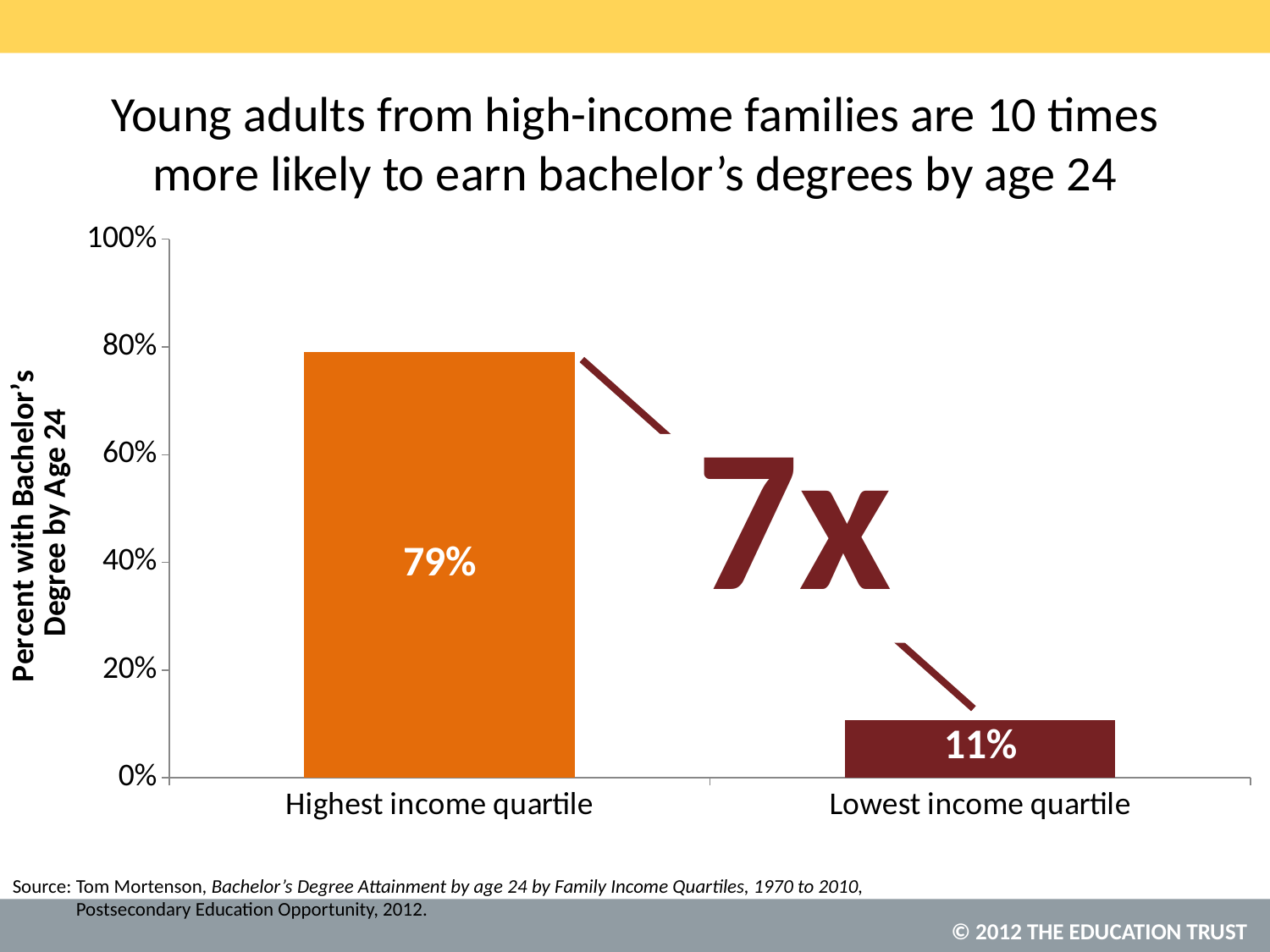
Which category has the highest value? Highest income quartile How many categories are shown on the x axis? 2 What is the difference between the values for Highest income quartile and Lowest income quartile? 68% Is the value for Lowest income quartile greater or less than 20%? less What is the value for Highest income quartile? 79% What kind of chart is shown on the slide? bar chart What is the label of the y axis? Percent with Bachelor's Degree by Age 24 Which is larger, the value for Highest income quartile or Lowest income quartile? Highest income quartile Which category has the lowest value? Lowest income quartile Is the value for Highest income quartile greater or less than 60%? greater What is the value for Lowest income quartile? 11% What multiplier is printed in large text between the two bars? 7x